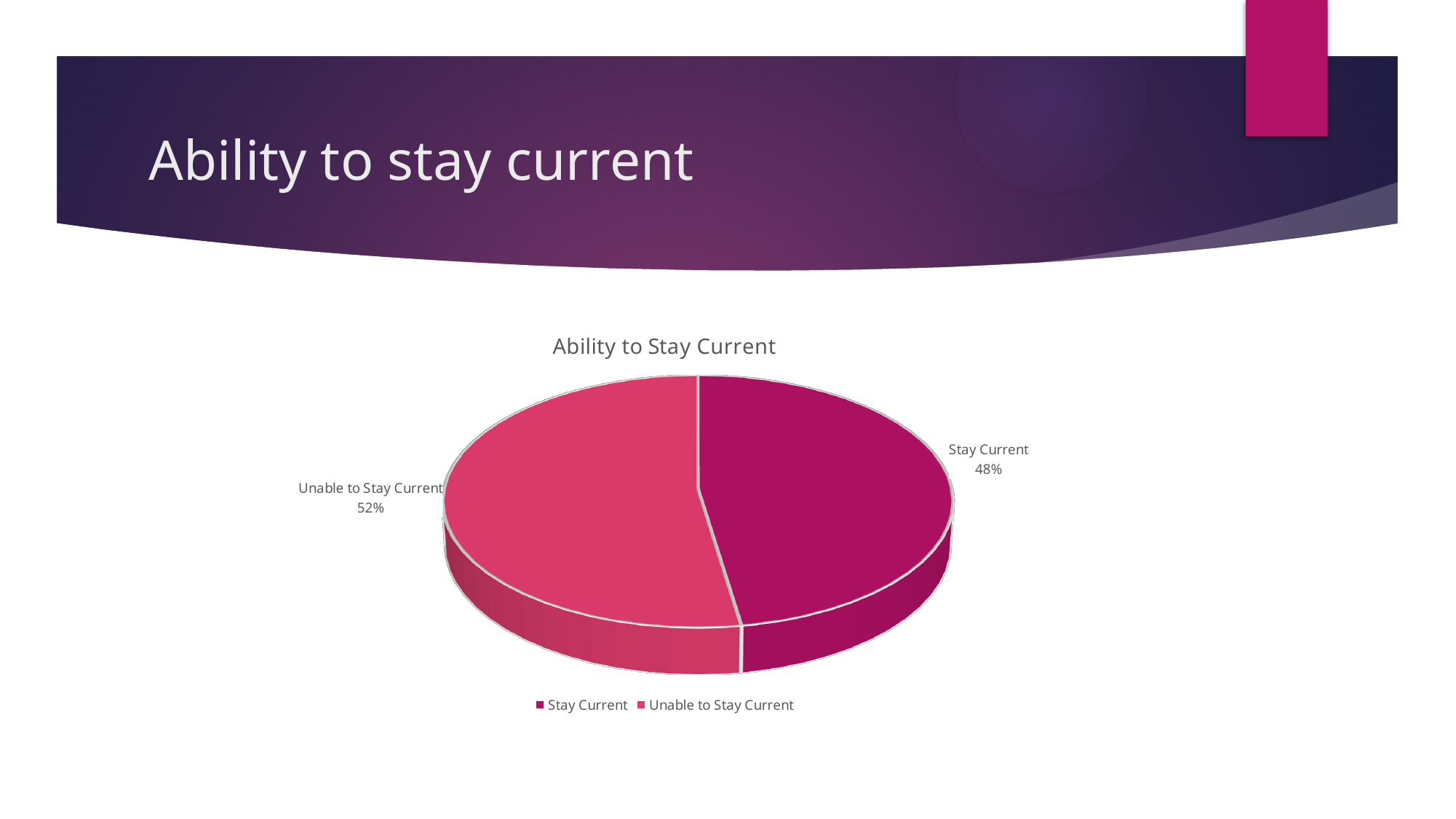
Which legend entry is shown in the lighter pink colour? Unable to Stay Current What is the title of the chart? Ability to Stay Current How many slices does the pie chart have? 2 Which is larger, the "Stay Current" slice or the "Unable to Stay Current" slice? Unable to Stay Current How many entries does the legend list? 2 Which slice of the pie is the largest? Unable to Stay Current What kind of chart is shown on the slide? Pie chart What percentage of the pie is labelled "Stay Current"? 48% What share of the pie does the "Stay Current" slice represent? 48% What percentage of the pie is labelled "Unable to Stay Current"? 52% Which slice of the pie is the smallest? Stay Current What is the difference in percentage points between the "Unable to Stay Current" and "Stay Current" slices? 4